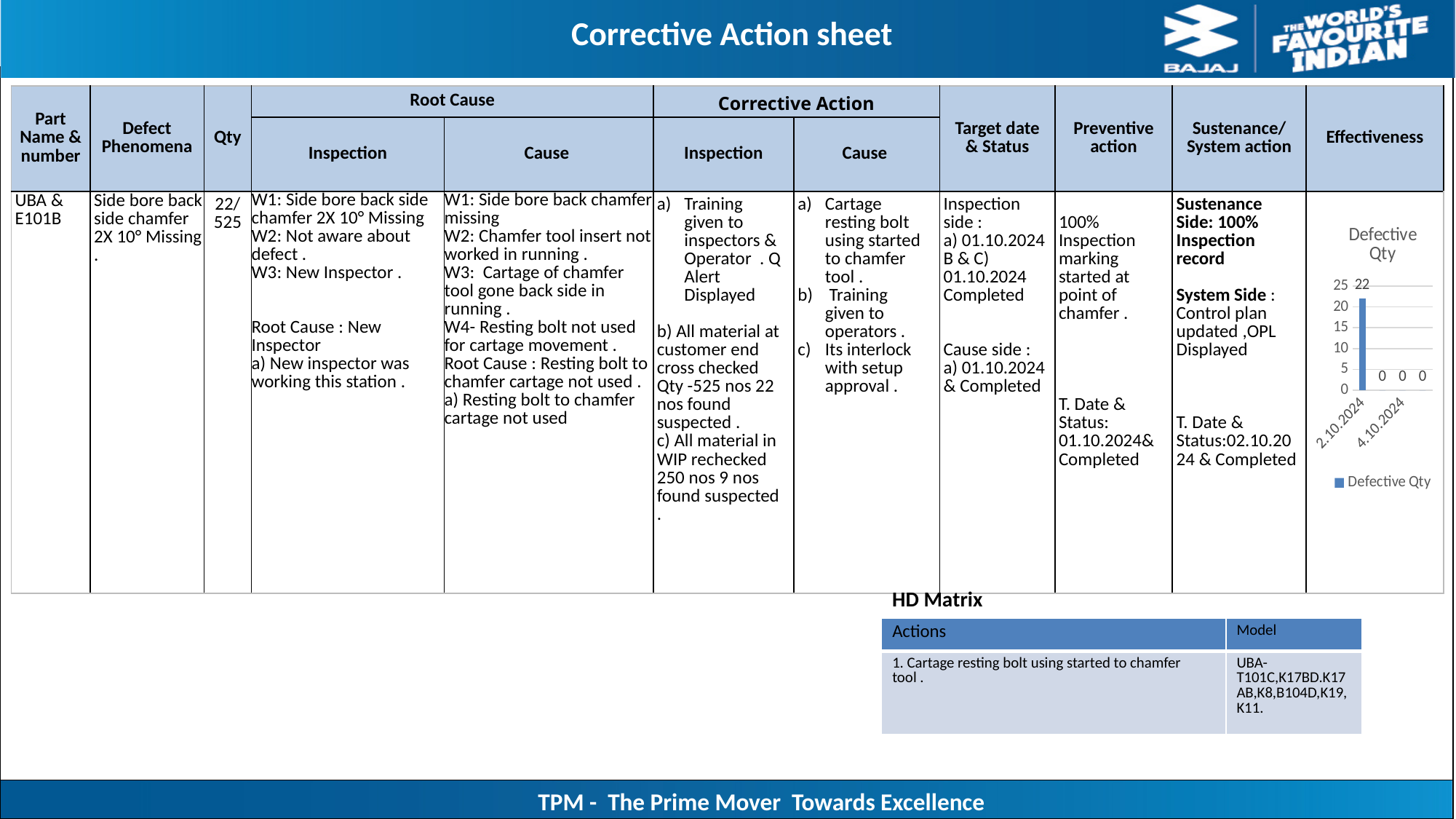
What is the Defective Qty value for 2.10.2024? 22 What is the highest value shown on the y axis of the Defective Qty chart? 25 How many data labels in the Defective Qty chart show a value of 0? 3 Which has a larger Defective Qty, 2.10.2024 or 4.10.2024? 2.10.2024 What is the title of the chart on the slide? Defective Qty What is the Defective Qty value for 4.10.2024? 0 Which date has the highest Defective Qty? 2.10.2024 How many series does the legend of the Defective Qty chart list? 1 Is the Defective Qty for 2.10.2024 greater or less than 20? greater Do the Defective Qty values rise or fall from 2.10.2024 to 4.10.2024? fall What is the difference in Defective Qty between 2.10.2024 and 4.10.2024? 22 What kind of chart is the Defective Qty chart? bar chart